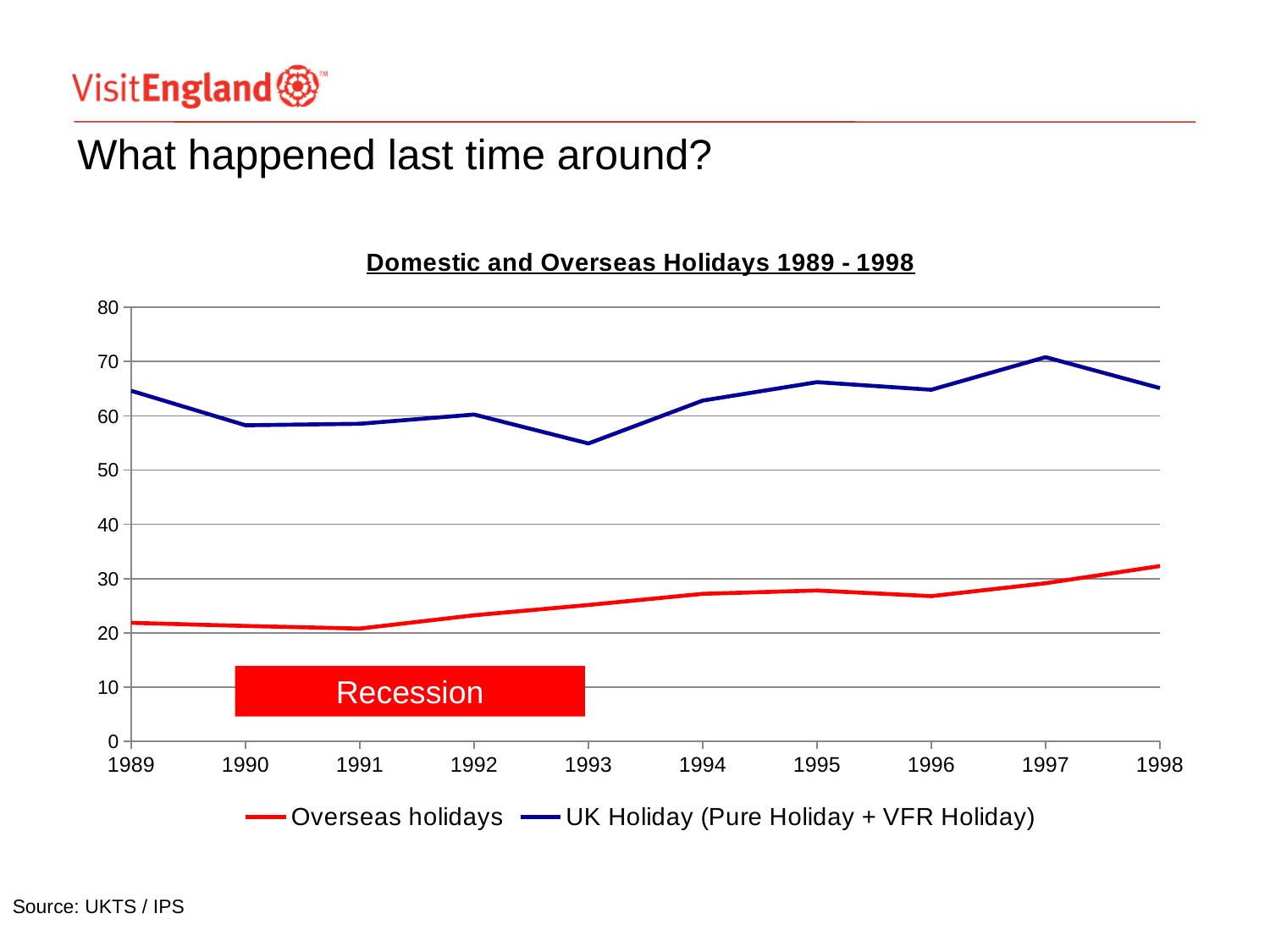
What kind of chart is shown on the slide? Line chart What is the title of the chart? Domestic and Overseas Holidays 1989 - 1998 Is the value for UK Holiday (Pure Holiday + VFR Holiday) in 1993 greater or less than 60? less Is the value for Overseas holidays in 1998 greater or less than 30? greater How many years are plotted along the x axis? 10 In which year does the UK Holiday (Pure Holiday + VFR Holiday) series reach its lowest value? 1993 Which series has the larger value in 1995, Overseas holidays or UK Holiday (Pure Holiday + VFR Holiday)? UK Holiday (Pure Holiday + VFR Holiday) Do the Overseas holidays values rise or fall from 1991 to 1998? Rise In which year does the Overseas holidays series reach its lowest value? 1991 In which year does the Overseas holidays series reach its highest value? 1998 How many series does the legend list? 2 In which year does the UK Holiday (Pure Holiday + VFR Holiday) series reach its highest value? 1997